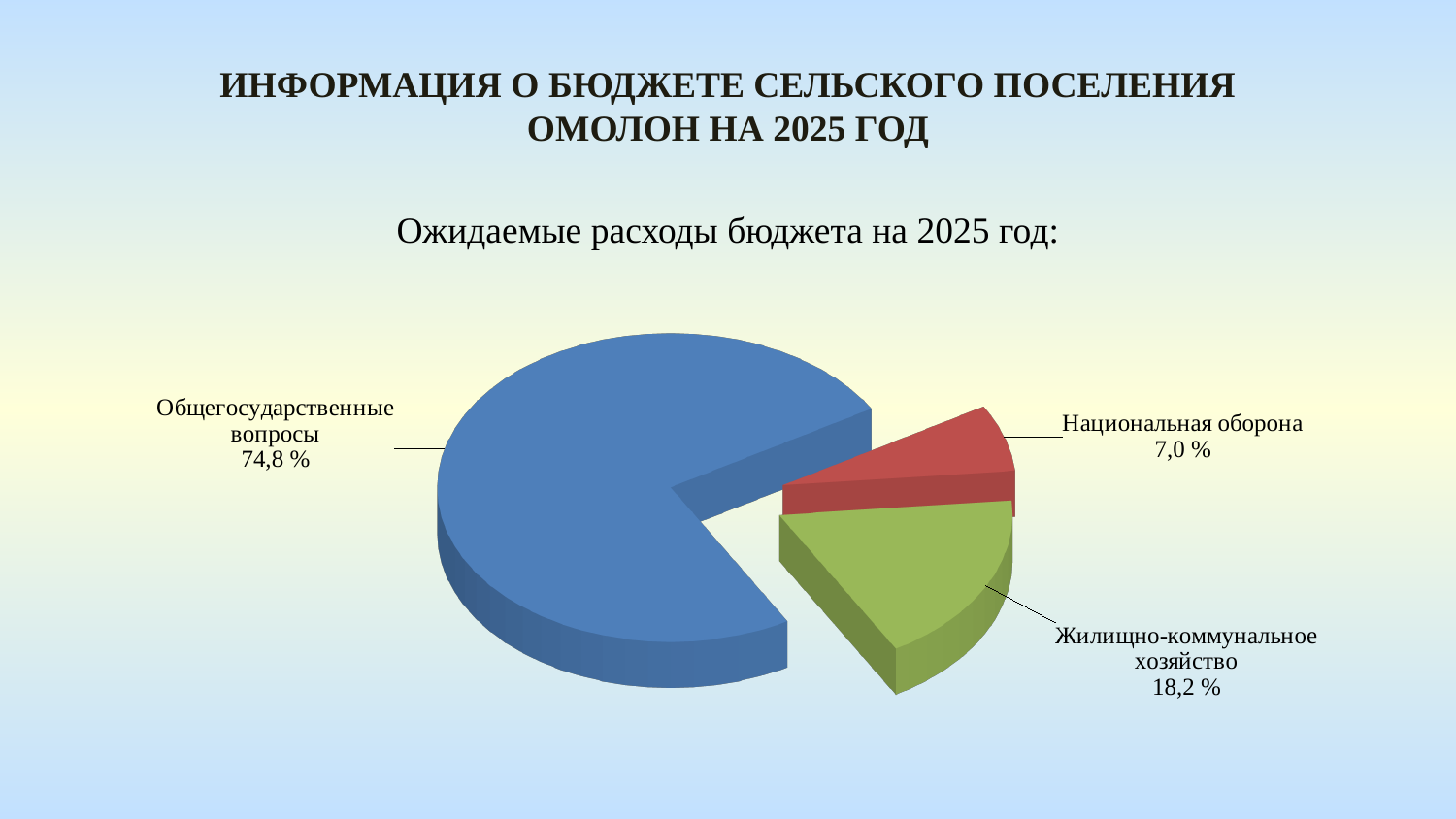
Which is larger: the share for Жилищно-коммунальное хозяйство or for Национальная оборона? Жилищно-коммунальное хозяйство How many slices does the pie chart have? 3 By how many percentage points does the share for Общегосударственные вопросы exceed the share for Жилищно-коммунальное хозяйство? 56,6 What share of expected 2025 budget expenditure goes to Общегосударственные вопросы? 74,8 % What kind of chart is shown on the slide? Pie chart What colour is the slice for Национальная оборона? Red By how many percentage points does the share for Жилищно-коммунальное хозяйство exceed the share for Национальная оборона? 11,2 What is the subtitle above the pie chart? Ожидаемые расходы бюджета на 2025 год: What share of expected 2025 budget expenditure goes to Жилищно-коммунальное хозяйство? 18,2 % Which category has the smallest share of the pie? Национальная оборона What share of expected 2025 budget expenditure goes to Национальная оборона? 7,0 % Which category has the largest share of the pie? Общегосударственные вопросы